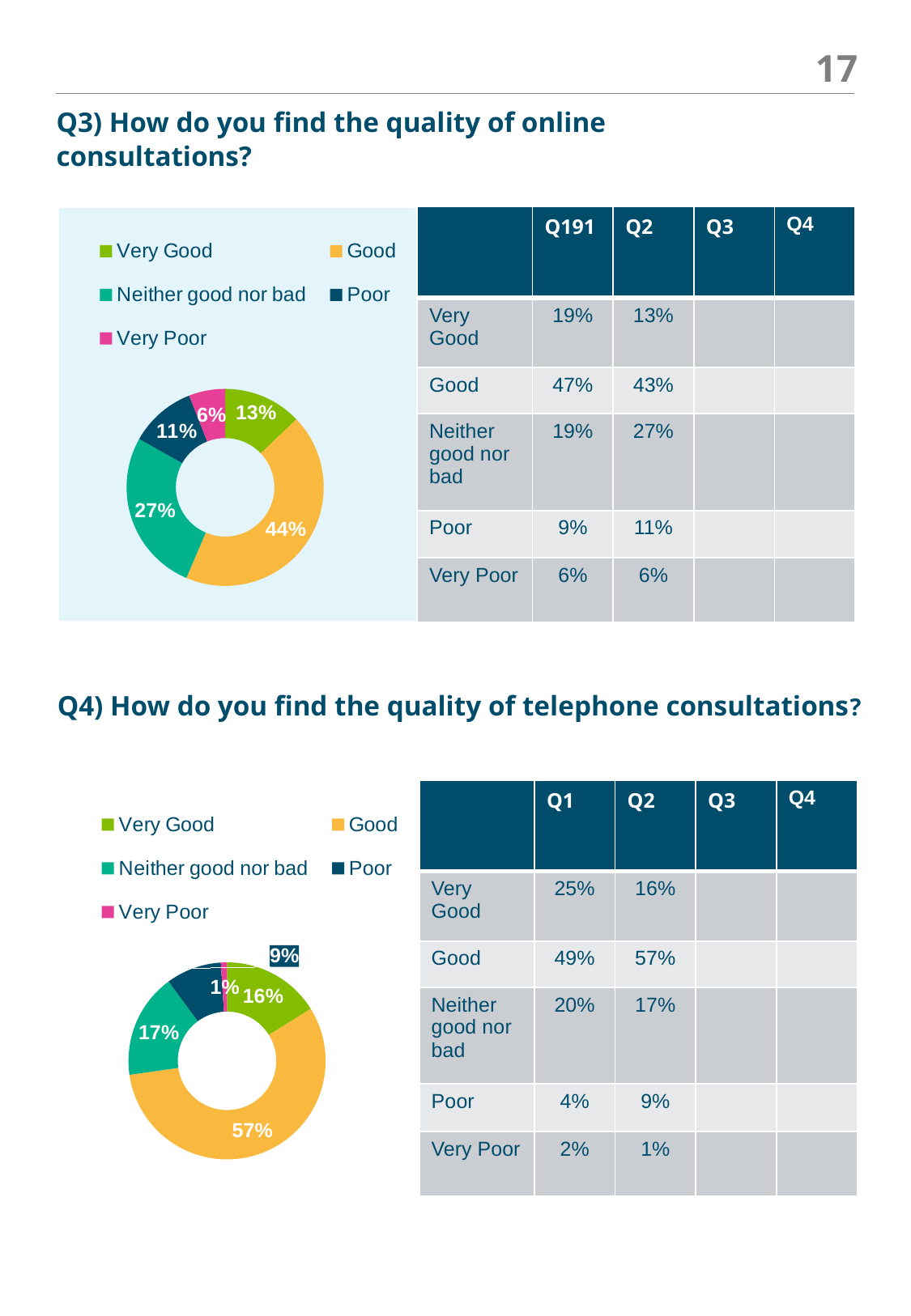
In the Q4 telephone consultations chart, which colour represents Very Poor in the legend? Pink In the Q3 online consultations chart, what is the difference between the Neither good nor bad share and the Very Good share? 14% In the Q4 telephone consultations chart, what percentage is shown for Very Poor? 1% In the Q3 online consultations chart, what percentage is shown for Good? 44% In the Q3 online consultations chart, what percentage is shown for Neither good nor bad? 27% In the Q3 online consultations chart, which category has the largest share? Good In the Q3 online consultations chart, which category has the smallest share? Very Poor In the Q4 telephone consultations chart, what is the difference between the Good share and the Poor share? 48% In the Q3 online consultations chart, how many categories does the legend list? 5 What type of chart is used for Q3 online consultations? Doughnut chart In the Q4 telephone consultations chart, what percentage is shown for Good? 57% In the Q4 telephone consultations chart, which is larger, Very Good or Neither good nor bad? Neither good nor bad